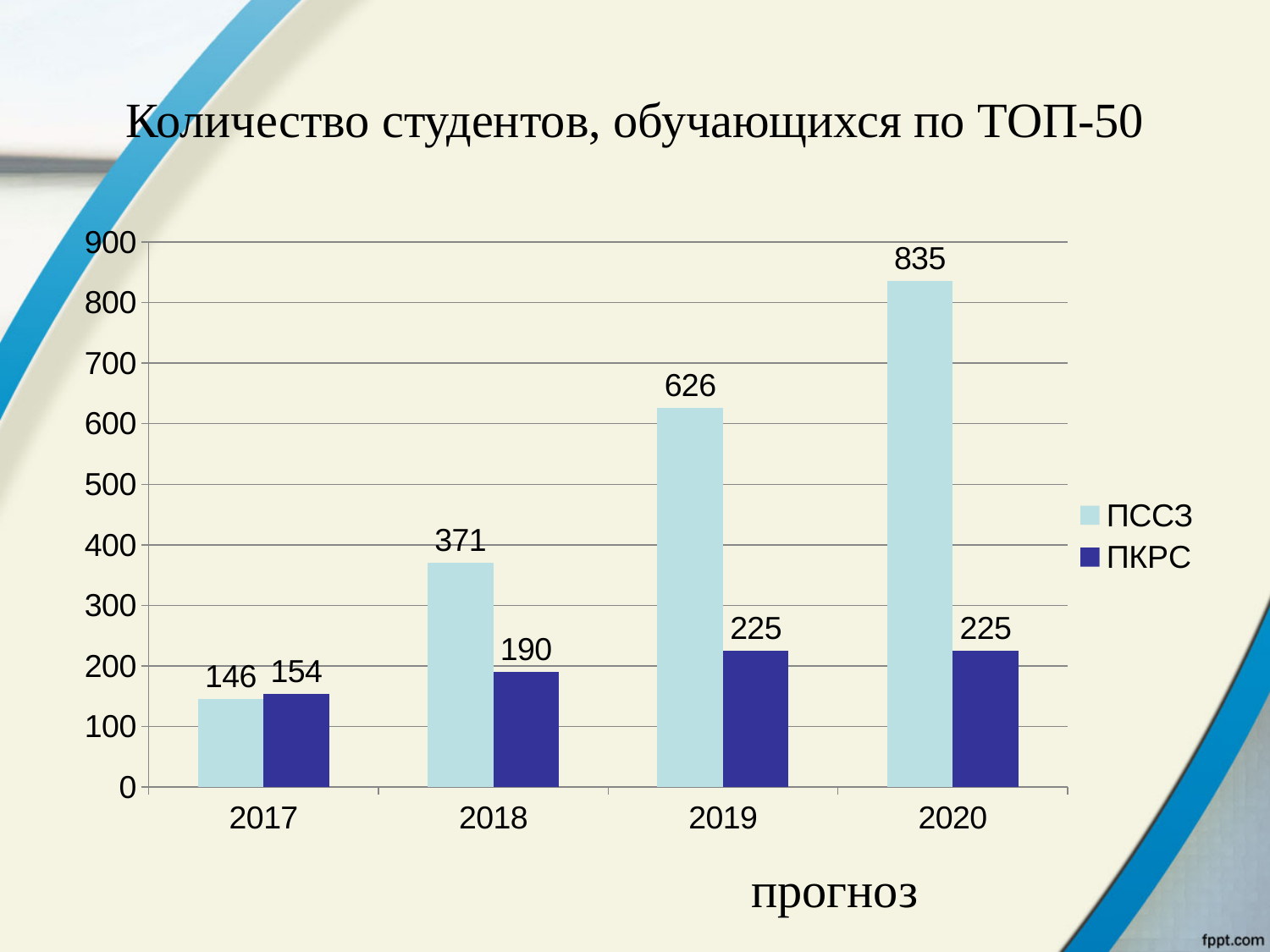
What kind of chart is shown on the slide? Bar chart How many series does the legend list? 2 What is the title of the chart? Количество студентов, обучающихся по ТОП-50 In which year is the ПКРС value lowest? 2017 In which year is the ПССЗ value highest? 2020 Do the ПССЗ values rise or fall from 2017 to 2020? Rise How many years are shown on the x axis? 4 Which is larger in 2017, ПССЗ or ПКРС? ПКРС What is the value for ПССЗ in 2017? 146 What is the value for ПССЗ in 2019? 626 What is the value for ПКРС in 2018? 190 What is the difference between the ПССЗ and ПКРС values in 2020? 610